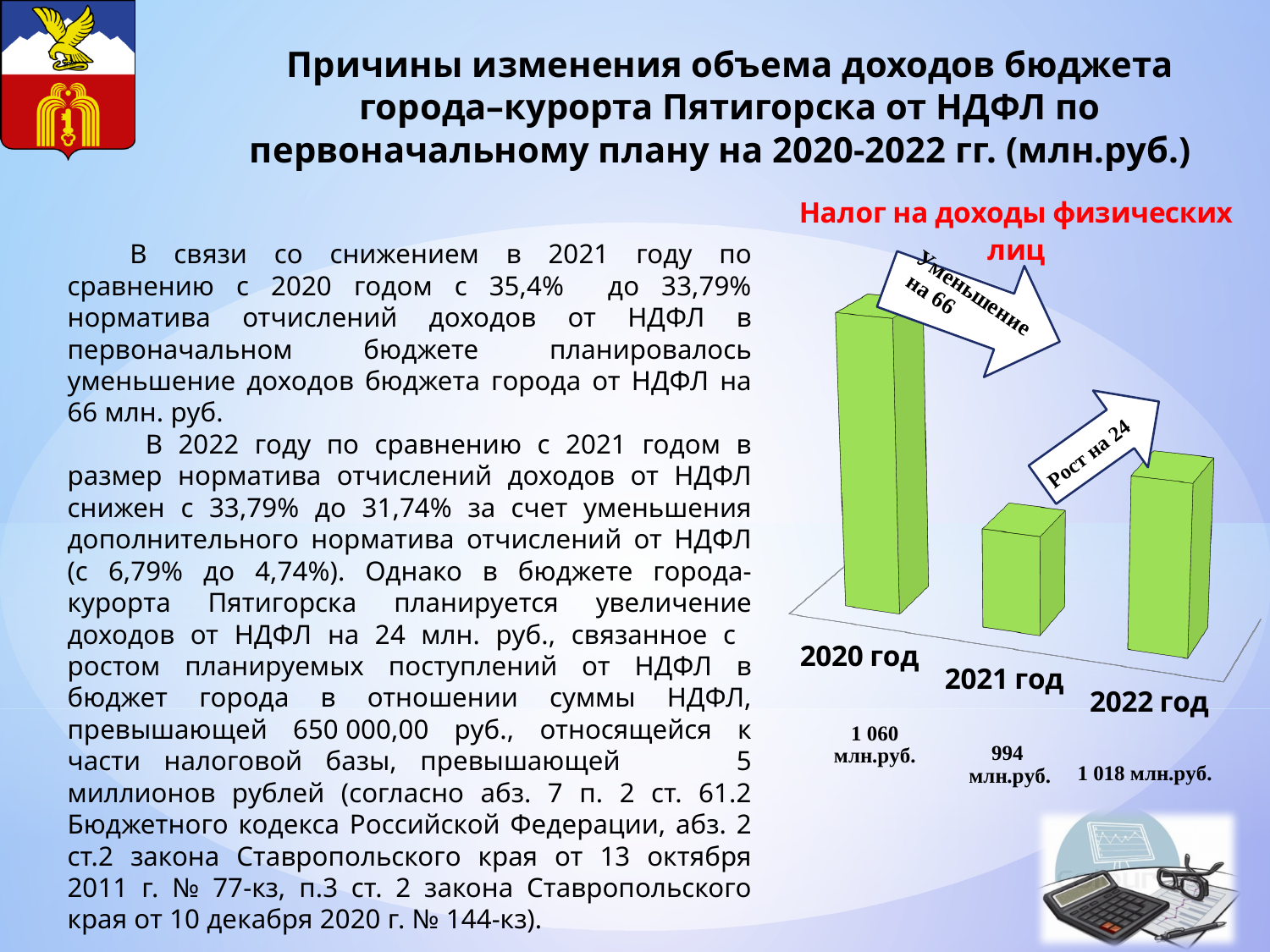
What is the difference between the values for 2020 год and 2021 год? 66 млн.руб. Which year has the lowest value in the chart? 2021 год How many years (categories) are shown in the chart? 3 What kind of chart is shown on the slide? Bar chart What is the value for 2022 год in the chart? 1 018 млн.руб. What does the arrow between the 2021 and 2022 bars say? Рост на 24 What is the difference between the values for 2022 год and 2021 год? 24 млн.руб. Which year has the highest value in the chart? 2020 год Which is larger, the value for 2020 год or the value for 2022 год? 2020 год What is the value for 2021 год in the chart? 994 млн.руб. What is the value for 2020 год in the chart? 1 060 млн.руб. What is the title of the chart? Налог на доходы физических лиц